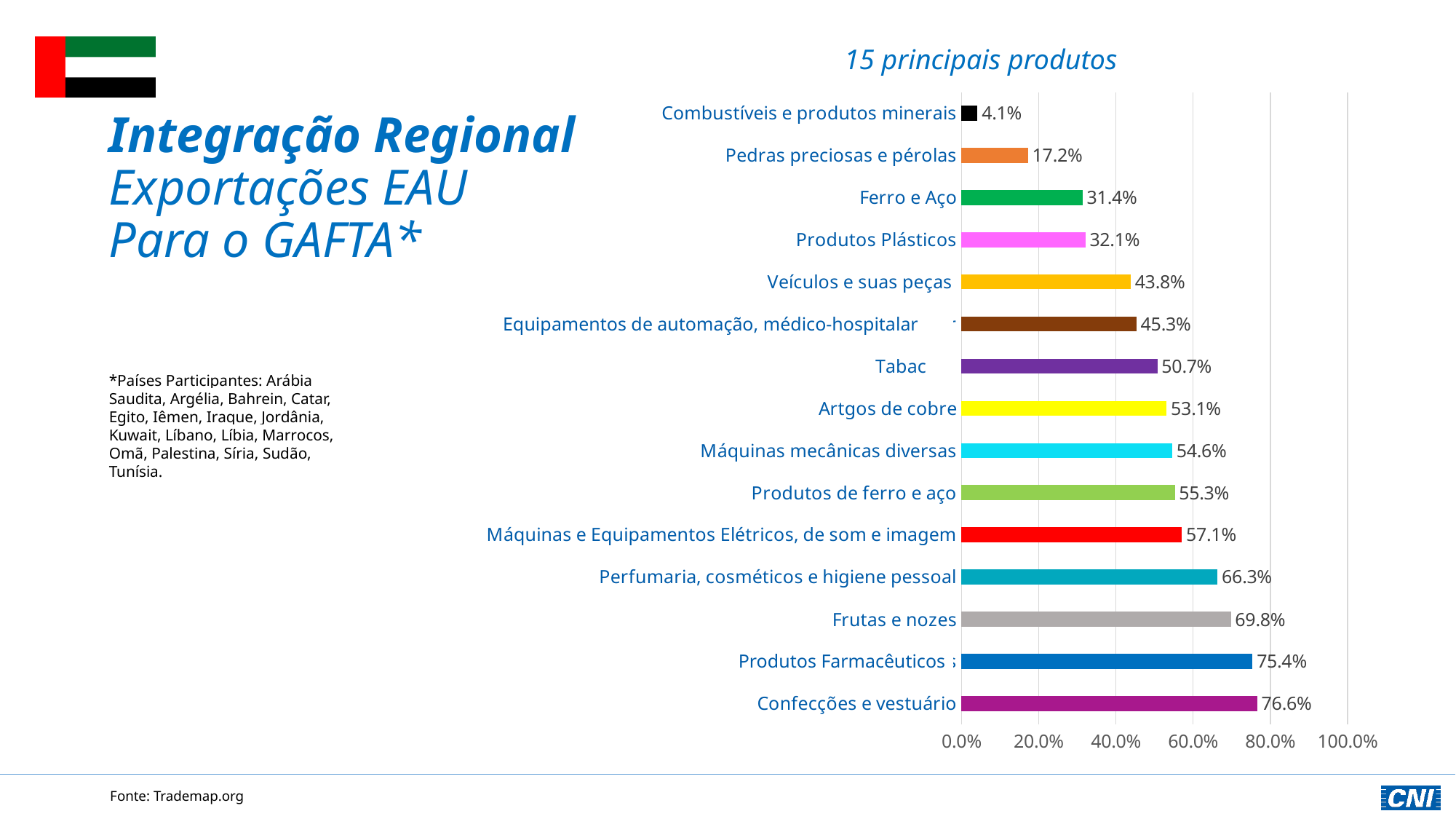
What kind of chart is shown on the slide? bar chart Which category has the lowest value? Combustíveis e produtos minerais Which category has the highest value? Confecções e vestuário What is the value for Tabac? 50.7% What is the difference between the values for Pedras preciosas e pérolas and Combustíveis e produtos minerais? 13.1% Is the value for Perfumaria, cosméticos e higiene pessoal greater or less than 60.0%? greater What is the value for Frutas e nozes? 69.8% Which is larger, the value for Ferro e Aço or the value for Produtos Plásticos? Produtos Plásticos How many categories are shown in the chart? 15 What is the value for Veículos e suas peças? 43.8% What is the title of the chart? 15 principais produtos What is the difference between the values for Produtos Farmacêuticos and Frutas e nozes? 5.6%